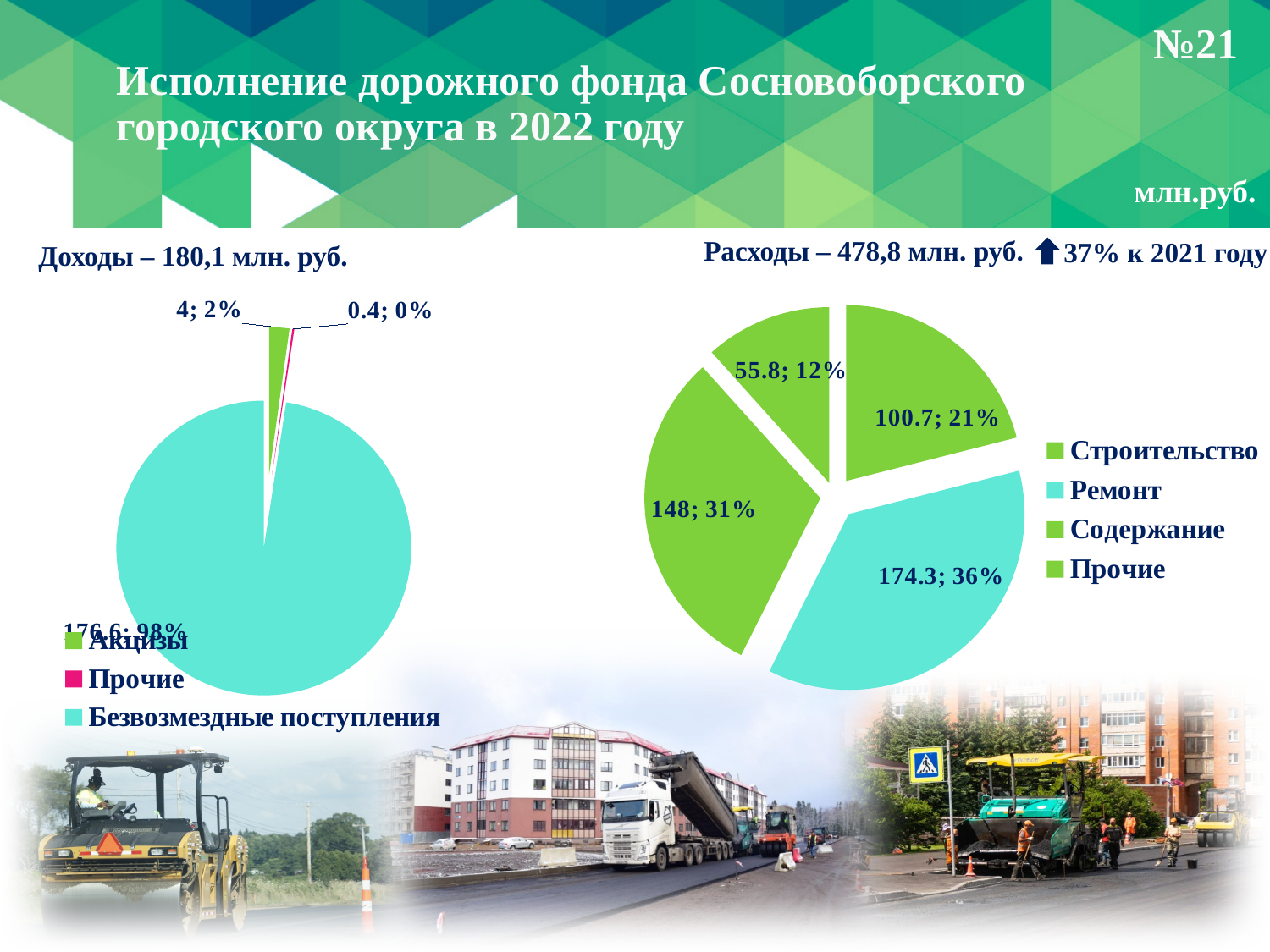
In the Доходы chart on the left, what colour is the Прочие slice? pink In the Расходы chart on the right, which category has the largest slice? Ремонт In the Доходы chart on the left, what is the value for Акцизы? 4; 2% In the Расходы chart on the right, how many categories does the legend list? 4 In the Доходы chart on the left, what share of the pie does Безвозмездные поступления take? 98% In the Доходы chart on the left, which is larger, Акцизы or Прочие? Акцизы In the Расходы chart on the right, which category has the smallest slice? Прочие What type of chart is used for the Расходы (expenses) chart on the right? pie chart In the Расходы chart on the right, what is the value for Строительство? 100.7; 21% In the Расходы chart on the right, what share of the pie does Содержание take? 31% In the Расходы chart on the right, what is the difference between the values for Ремонт and Содержание? 26.3 In the Расходы chart on the right, what is the value for Ремонт? 174.3; 36%